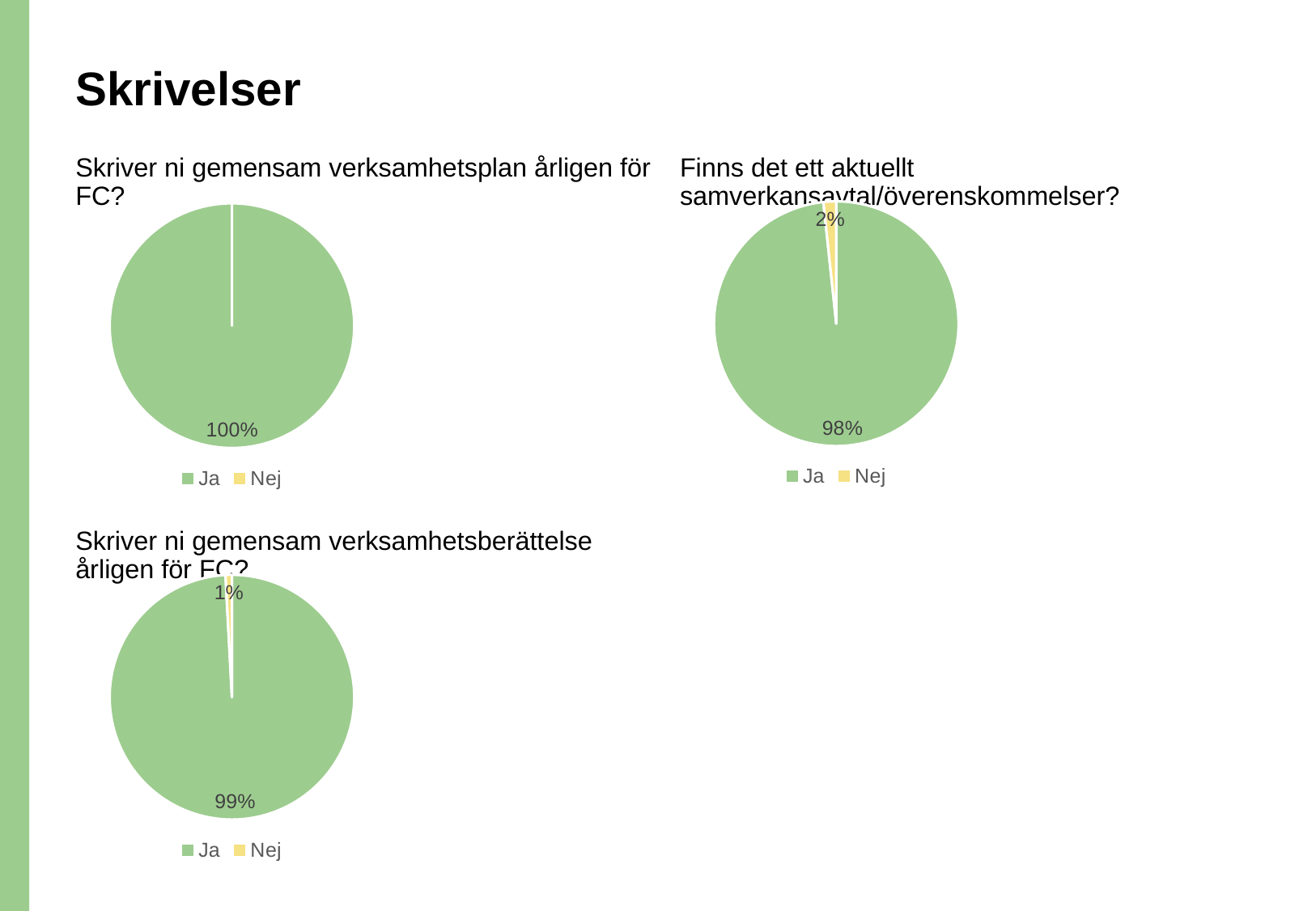
In the chart titled "Finns det ett aktuellt samverkansavtal/överenskommelser?", what is the difference between the "Ja" and "Nej" shares? 96% What kind of chart is the one titled "Skriver ni gemensam verksamhetsplan årligen för FC?"? Pie chart How many pie charts are shown on the slide? 3 In the chart titled "Skriver ni gemensam verksamhetsberättelse årligen för FC?", which category is the smallest? Nej In the chart titled "Skriver ni gemensam verksamhetsplan årligen för FC?", what share of the pie is "Ja"? 100% In the chart titled "Skriver ni gemensam verksamhetsberättelse årligen för FC?", what share of the pie is "Ja"? 99% In the chart titled "Finns det ett aktuellt samverkansavtal/överenskommelser?", which category is the largest? Ja In the chart titled "Finns det ett aktuellt samverkansavtal/överenskommelser?", what share of the pie is "Nej"? 2% In the chart titled "Skriver ni gemensam verksamhetsberättelse årligen för FC?", which is larger, "Ja" or "Nej"? Ja How many entries does the legend list in the chart titled "Finns det ett aktuellt samverkansavtal/överenskommelser?"? 2